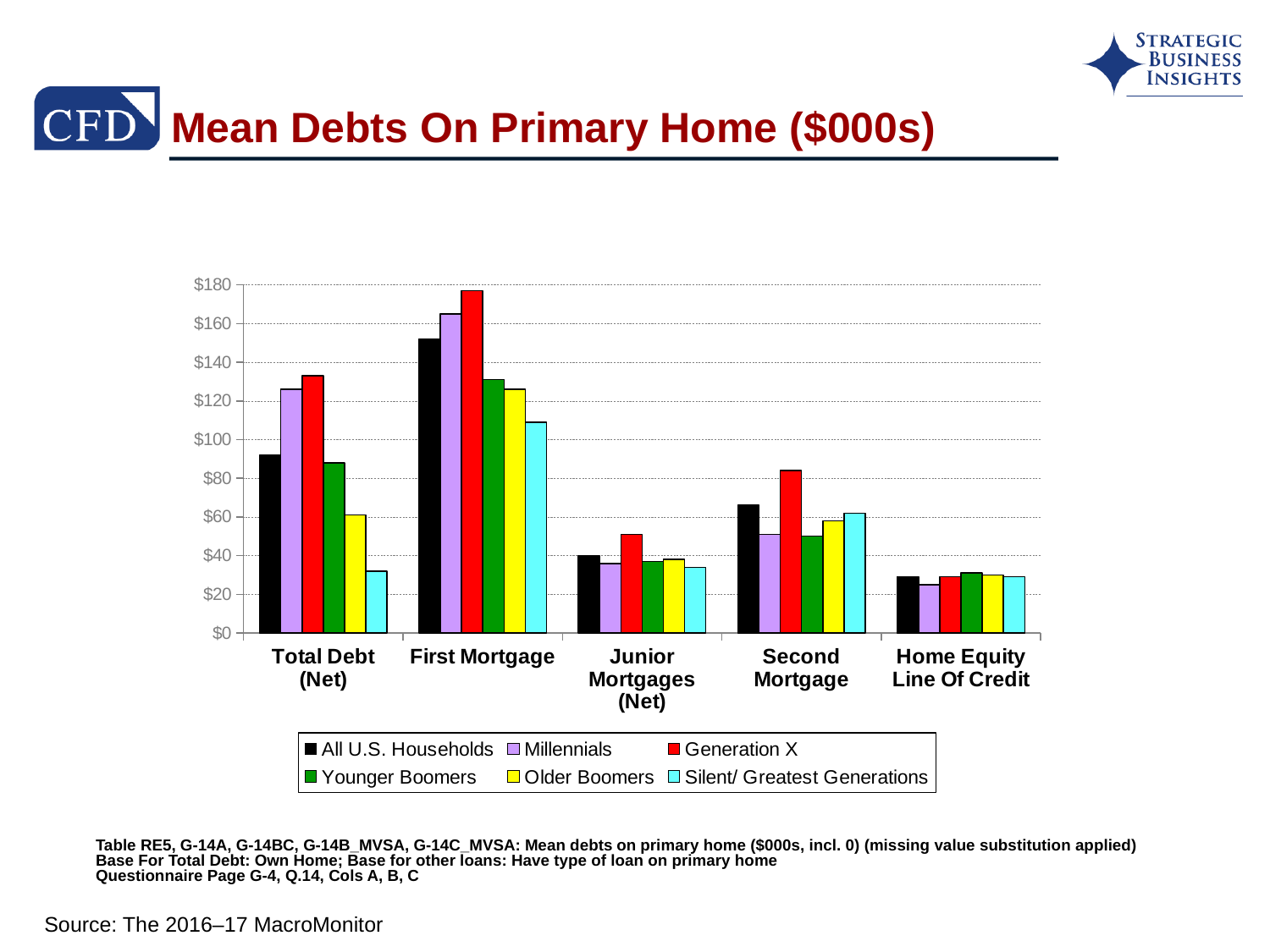
How many debt categories are shown along the x axis? 5 What kind of chart is shown on the slide? bar chart Is the Total Debt (Net) value for Silent/ Greatest Generations greater or less than $40? less Which group has the highest mean Second Mortgage debt? Generation X What is the title of the chart on the slide? Mean Debts On Primary Home ($000s) Is the First Mortgage value for Generation X greater or less than $160? greater For Total Debt (Net), which is larger: Millennials or Younger Boomers? Millennials Is the First Mortgage value for Silent/ Greatest Generations greater or less than $100? greater How many series does the legend list? 6 Which group has the lowest mean Total Debt (Net)? Silent/ Greatest Generations Which group has the highest mean First Mortgage debt? Generation X